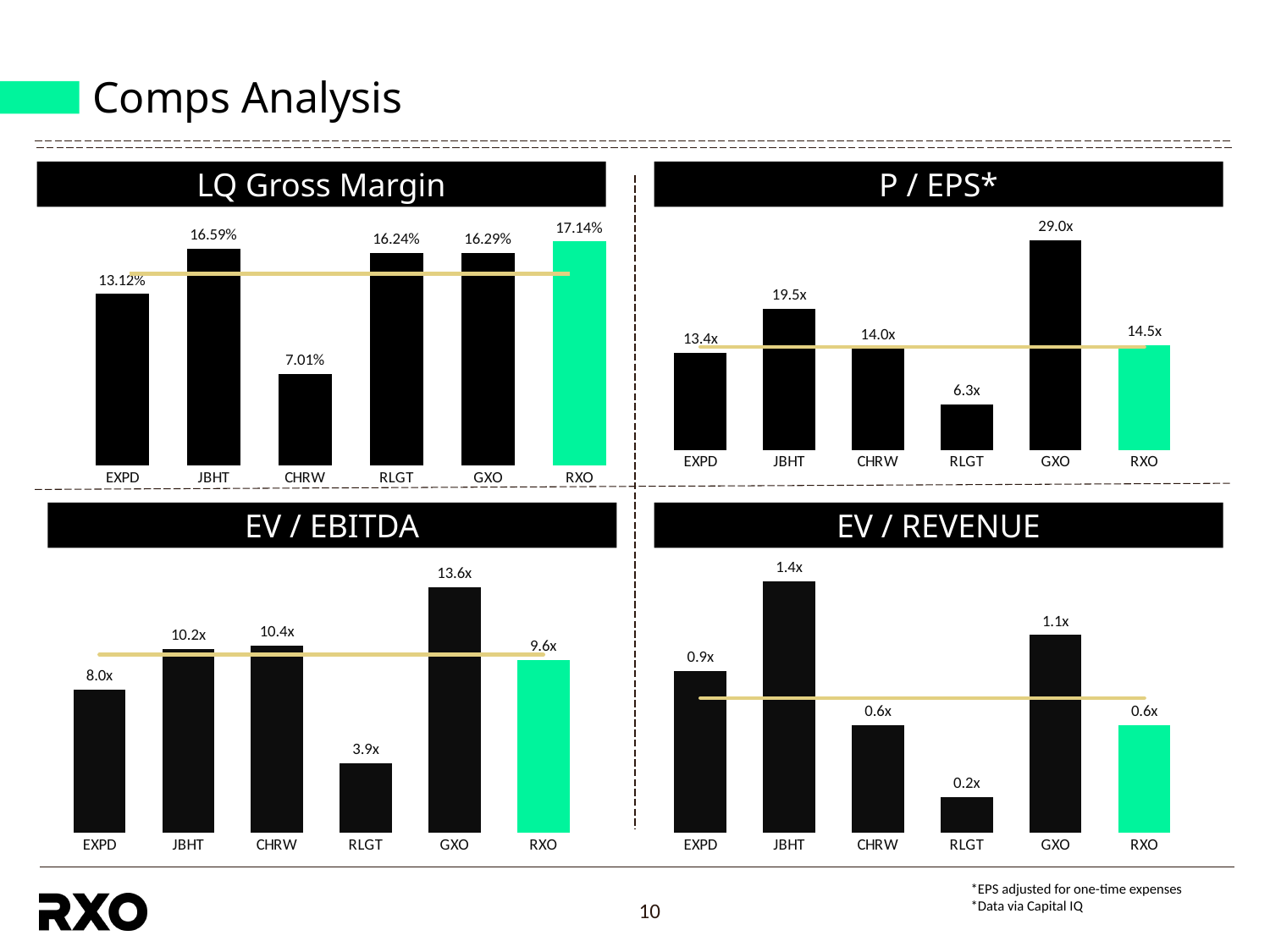
What type of chart is the EV / EBITDA chart? Bar chart In the EV / REVENUE chart, which company has the highest value? JBHT In the P / EPS* chart, which company has the lowest value? RLGT In the P / EPS* chart, what is the value for GXO? 29.0x In the EV / EBITDA chart, what is the difference between GXO and RLGT? 9.7x How many companies are shown in the EV / REVENUE chart? 6 In the EV / REVENUE chart, what is the value for RLGT? 0.2x In the LQ Gross Margin chart, which company has the highest gross margin? RXO In the P / EPS* chart, which is larger, JBHT or RXO? JBHT In the LQ Gross Margin chart, what is the value for CHRW? 7.01% In the EV / EBITDA chart, what is the value for RXO? 9.6x In the LQ Gross Margin chart, what is the difference between RXO and EXPD? 4.02%